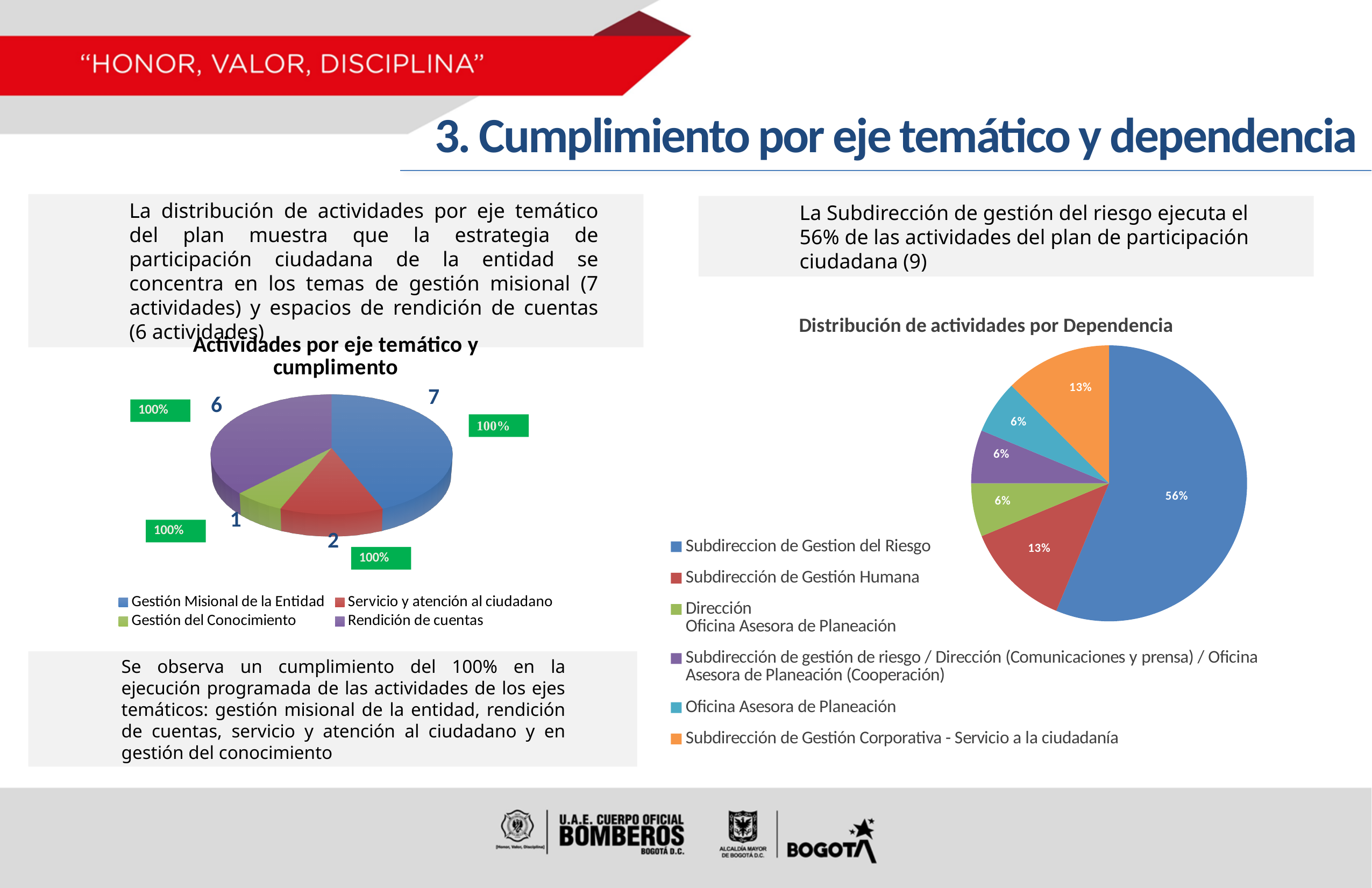
In the chart titled "Actividades por eje temático y cumplimento", which category has the largest number of activities? Gestión Misional de la Entidad In the chart titled "Actividades por eje temático y cumplimento", how many activities are shown for Gestión Misional de la Entidad? 7 In the chart titled "Actividades por eje temático y cumplimento", which category has the smallest number of activities? Gestión del Conocimiento In the chart titled "Distribución de actividades por Dependencia", what share of activities belongs to Oficina Asesora de Planeación? 6% In the chart titled "Actividades por eje temático y cumplimento", what is the difference between the activities for Gestión Misional de la Entidad and Servicio y atención al ciudadano? 5 In the chart titled "Actividades por eje temático y cumplimento", how many activities are shown for Rendición de cuentas? 6 What kind of chart is "Distribución de actividades por Dependencia"? Pie chart In the chart titled "Distribución de actividades por Dependencia", what share of activities belongs to Subdireccion de Gestion del Riesgo? 56% In the chart titled "Distribución de actividades por Dependencia", which is larger: the share for Subdirección de Gestión Corporativa - Servicio a la ciudadanía or the share for Oficina Asesora de Planeación? Subdirección de Gestión Corporativa - Servicio a la ciudadanía In the chart titled "Actividades por eje temático y cumplimento", how many categories does the legend list? 4 In the chart titled "Distribución de actividades por Dependencia", how many dependencies does the legend list? 6 In the chart titled "Distribución de actividades por Dependencia", what share of activities belongs to Subdirección de Gestión Humana? 13%